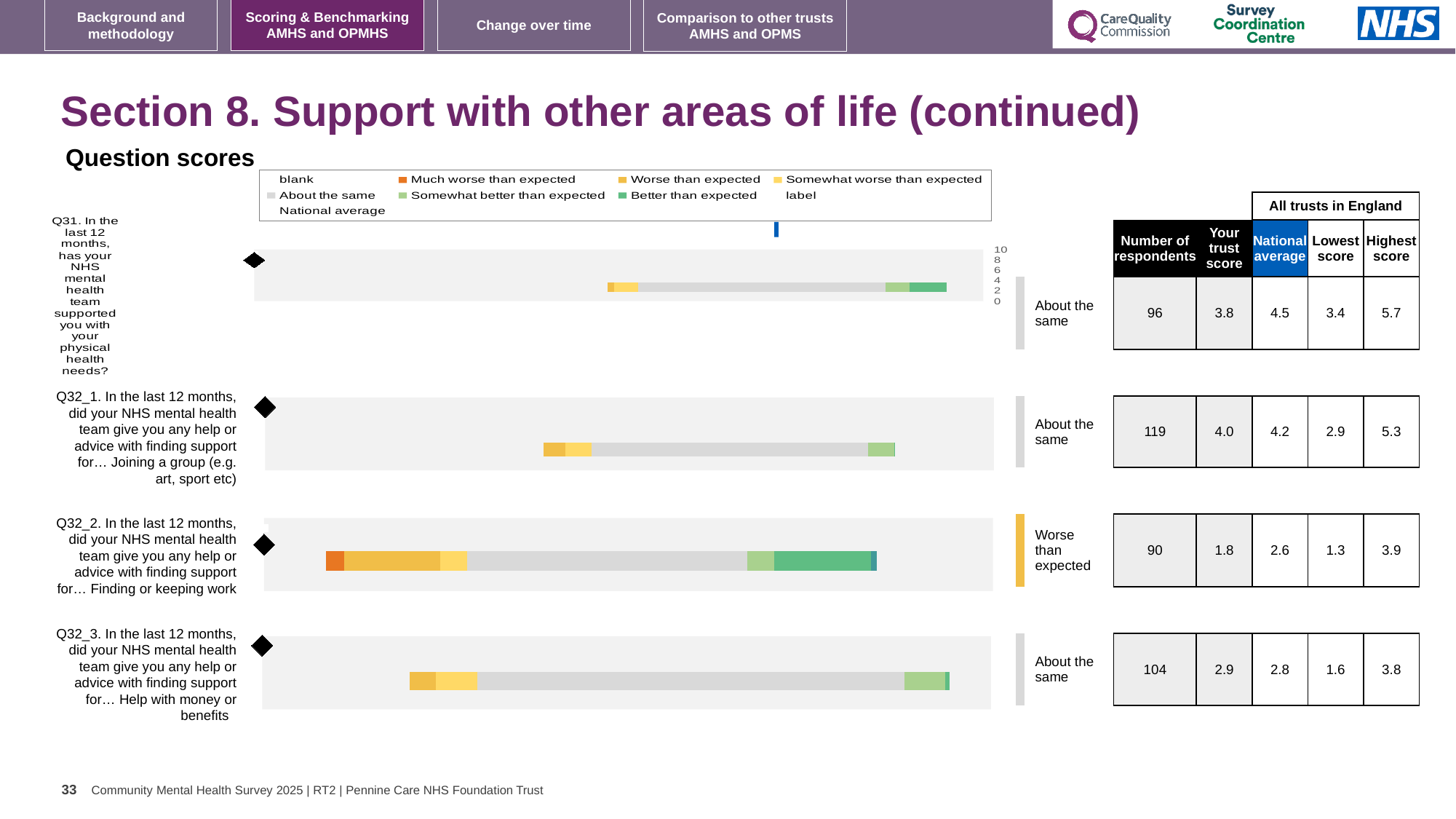
Which benchmark category is shown next to the bar for Q32_2 (Finding or keeping work)? Worse than expected What kind of chart is used to show the question scores on this slide? bar chart For Q31, what is the difference between the highest score and the lowest score across all trusts in England? 2.3 Which colour in the legend represents 'Much worse than expected'? orange Which benchmark category is shown next to the bar for Q32_3 (Help with money or benefits)? About the same How many respondents are recorded for Q32_3 (Help with money or benefits)? 104 How many questions are plotted as bars on this slide? 4 How many entries does the legend above the charts list? 9 What is the 'Your trust score' for Q32_2 (Finding or keeping work)? 1.8 Which bar has the larger 'Better than expected' (dark green) segment, Q31 or Q32_2? Q32_2 Which question has the highest 'Your trust score'? Q32_1 (Joining a group) Which question has the lowest 'Your trust score'? Q32_2 (Finding or keeping work)